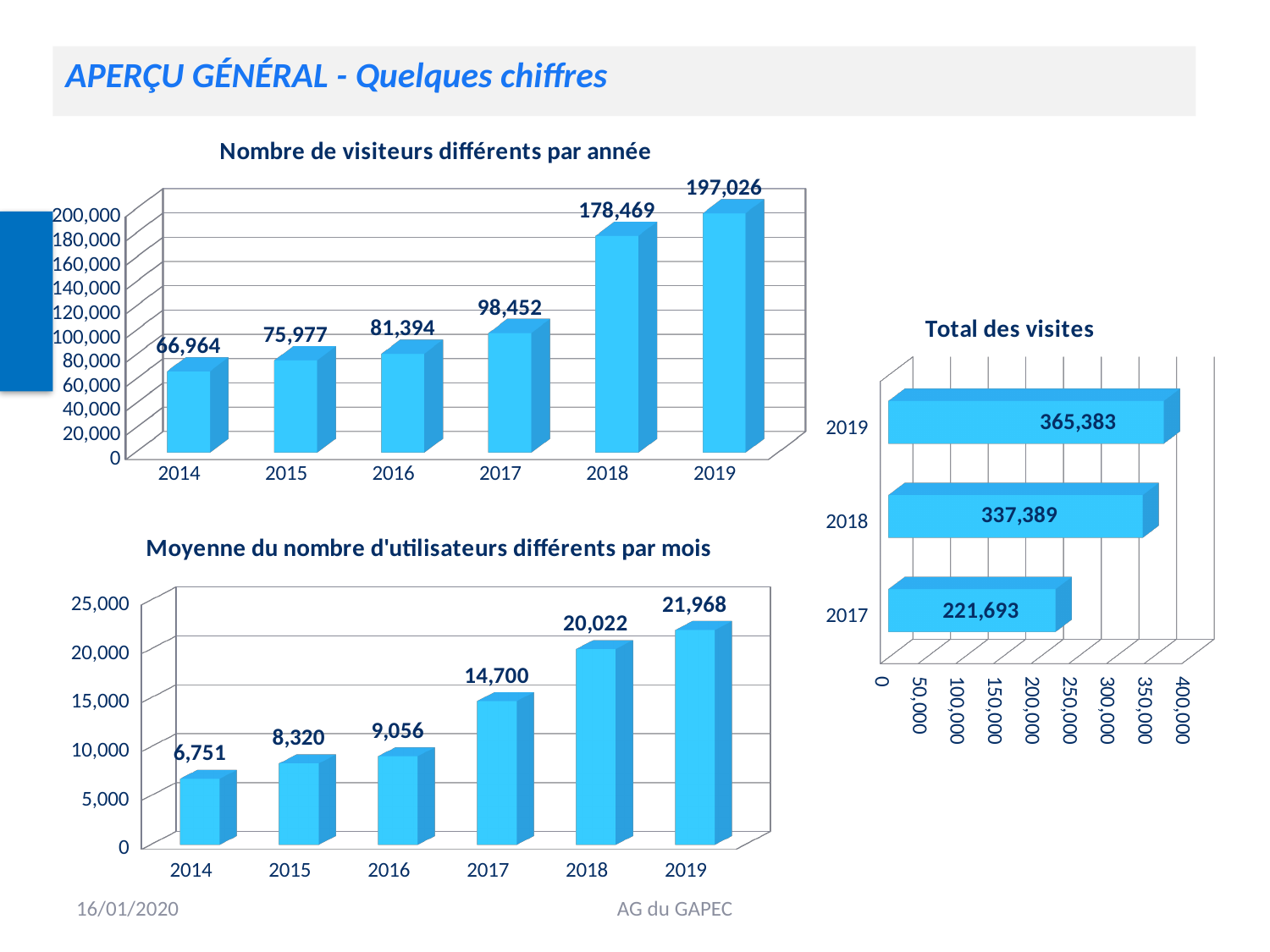
In the chart 'Total des visites', what is the difference between the values for 2019 and 2017? 143,690 In the chart 'Nombre de visiteurs différents par année', which year has the lowest value? 2014 In the chart 'Moyenne du nombre d'utilisateurs différents par mois', which year has the highest value? 2019 What kind of chart is 'Total des visites'? bar chart In the chart 'Moyenne du nombre d'utilisateurs différents par mois', what is the difference between the values for 2018 and 2017? 5,322 In the chart 'Total des visites', what is the value for 2018? 337,389 In the chart 'Nombre de visiteurs différents par année', what is the value for 2018? 178,469 In the chart 'Moyenne du nombre d'utilisateurs différents par mois', what is the value for 2017? 14,700 In the chart 'Moyenne du nombre d'utilisateurs différents par mois', which is larger, the value for 2015 or the value for 2016? 2016 In the chart 'Nombre de visiteurs différents par année', do the values rise or fall from 2014 to 2019? rise In the chart 'Nombre de visiteurs différents par année', what is the difference between the values for 2019 and 2018? 18,557 In the chart 'Nombre de visiteurs différents par année', how many years are shown? 6